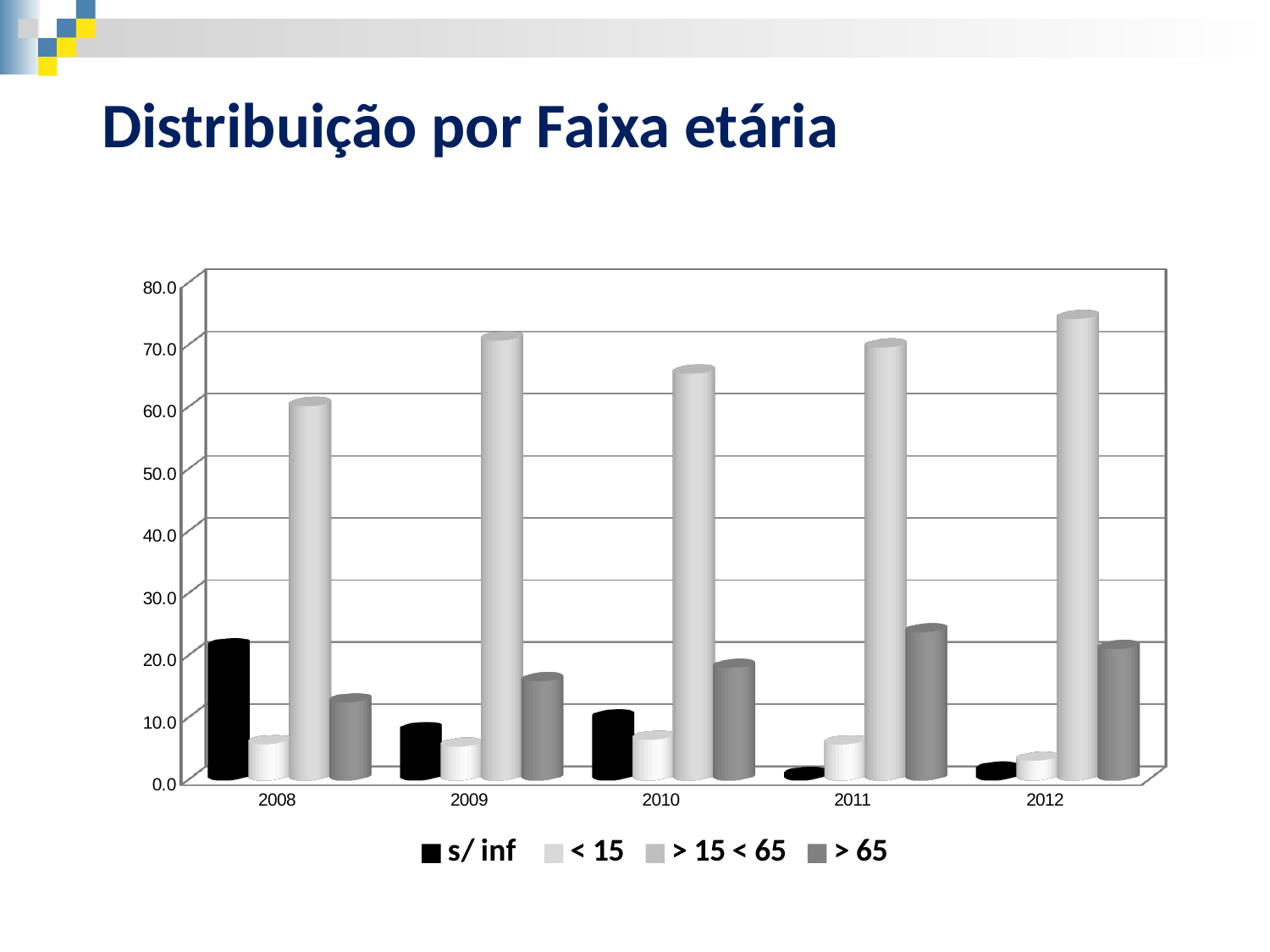
Which series is represented by the black bars? s/ inf How many series does the legend list? 4 Is the value for s/ inf in 2008 greater or less than 30? less Which is larger in 2010, the > 65 bar or the < 15 bar? > 65 How many years are shown on the x axis? 5 What kind of chart is shown on the slide? bar chart Is the value for > 15 < 65 in 2012 greater or less than 70? greater In which year is the s/ inf bar the highest? 2008 Is the value for > 65 in 2011 greater or less than 30? less In which year is the > 15 < 65 bar the highest? 2012 What is the title of the slide? Distribuição por Faixa etária